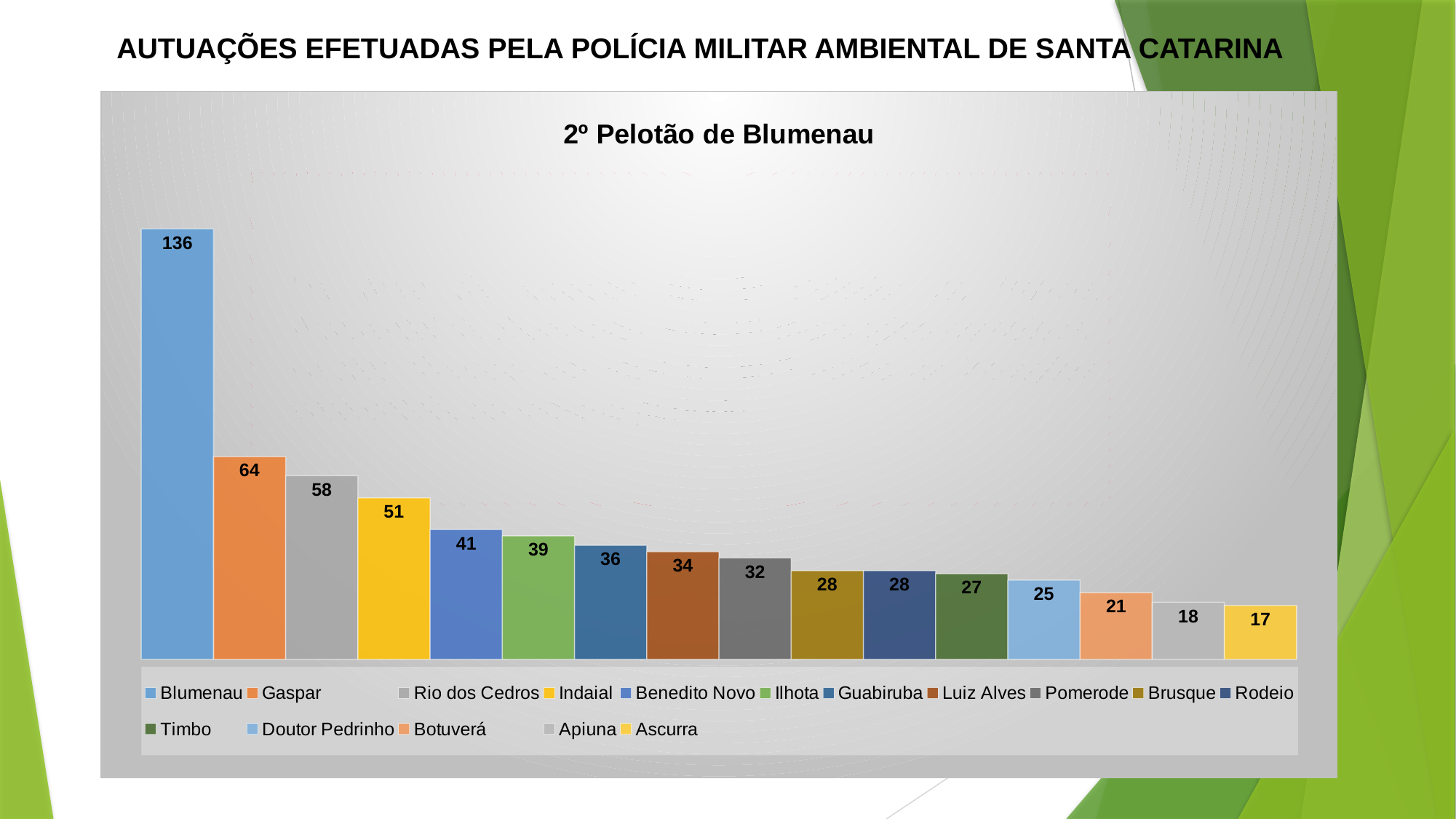
What is the difference between the values for Indaial and Benedito Novo? 10 What is the title of the chart? 2º Pelotão de Blumenau What is the value for Doutor Pedrinho? 25 How many bars are plotted in the chart? 16 Which is larger, the value for Ilhota or the value for Pomerode? Ilhota Which category has the lowest value? Ascurra What is the difference between the values for Blumenau and Gaspar? 72 What kind of chart is shown on the slide? Bar chart Which category has the highest value? Blumenau What is the value for Rio dos Cedros? 58 What is the value for Luiz Alves? 34 What is the value for Blumenau? 136